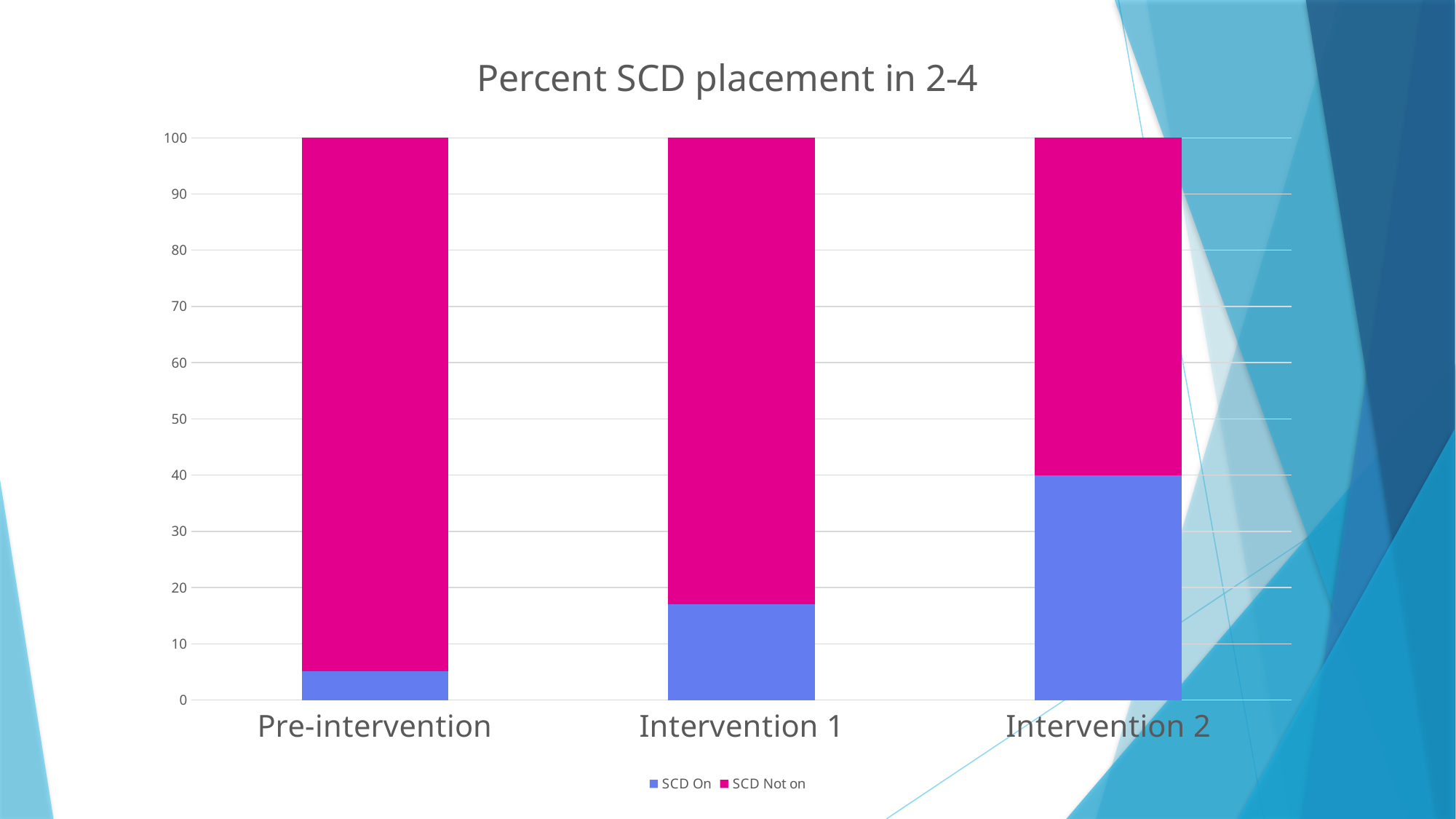
What kind of chart is shown on the slide? bar chart Which colour represents the SCD On series? blue Is the SCD On value for Intervention 1 greater or less than 20? less Is the SCD On value for Pre-intervention greater or less than 10? less What is the total of the stacked bar for Intervention 2? 100 How many categories are shown on the x axis? 3 Do the SCD On values rise or fall from Pre-intervention to Intervention 2? rise Which category has the highest SCD On value? Intervention 2 What is the title of the chart? Percent SCD placement in 2-4 How many series does the legend list? 2 Which category has the lowest SCD On value? Pre-intervention What is the SCD On value for Intervention 2? 40